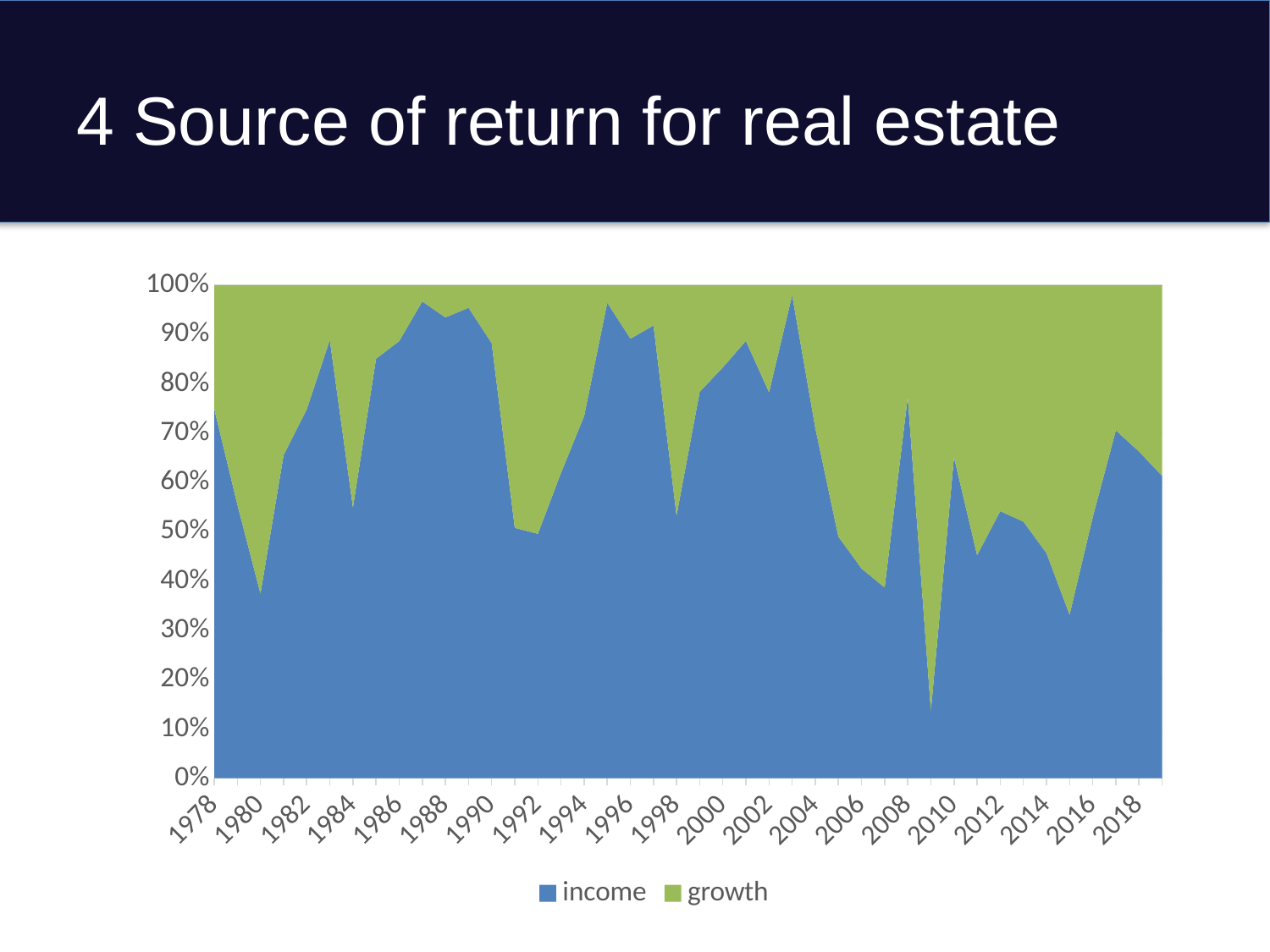
How many year labels are shown on the x axis? 21 Is the income share in 2009 greater or less than 20%? less Does the income share rise or fall between 2003 and 2007? Fall Is the income share in 1987 greater or less than 90%? greater Is the income share in 1980 greater or less than 50%? less What are the two series named in the legend? income and growth What kind of chart is shown on the slide? Area chart How many series does the legend list? 2 In which year is the income share of return at its lowest? 2009 Which colour represents the growth series? Green